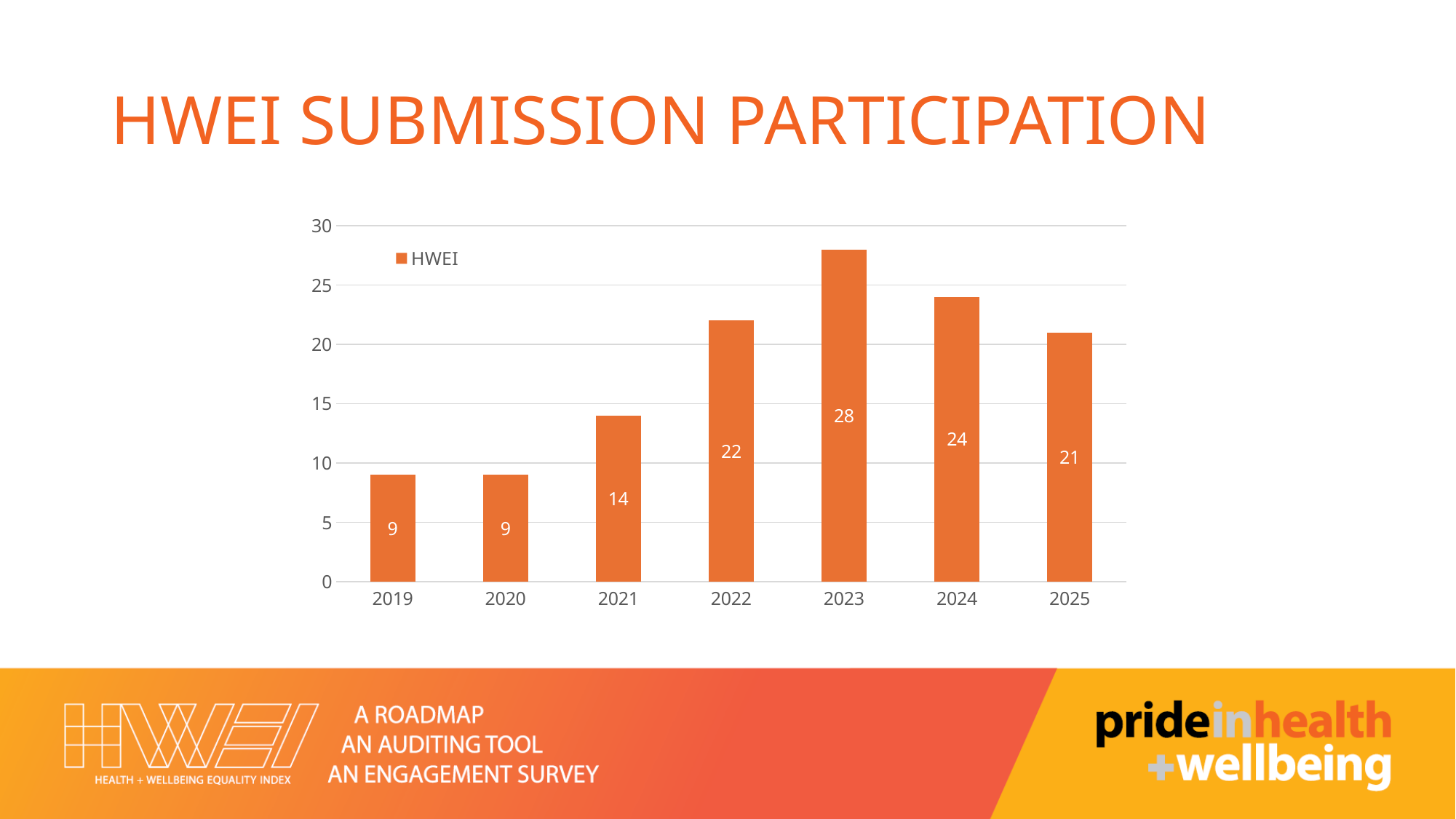
How many series does the legend list? 1 Is the HWEI value for 2024 greater or less than 20? greater What is the difference between the HWEI values for 2022 and 2021? 8 What kind of chart is shown on the slide? bar chart Do the HWEI values rise or fall from 2019 to 2023? rise How many years are shown on the x axis? 7 Which is larger, the HWEI value for 2022 or for 2025? 2022 Which year has the highest HWEI value? 2023 What is the HWEI value for 2021? 14 What is the HWEI value for 2023? 28 What is the HWEI value for 2025? 21 What is the difference between the HWEI values for 2023 and 2024? 4